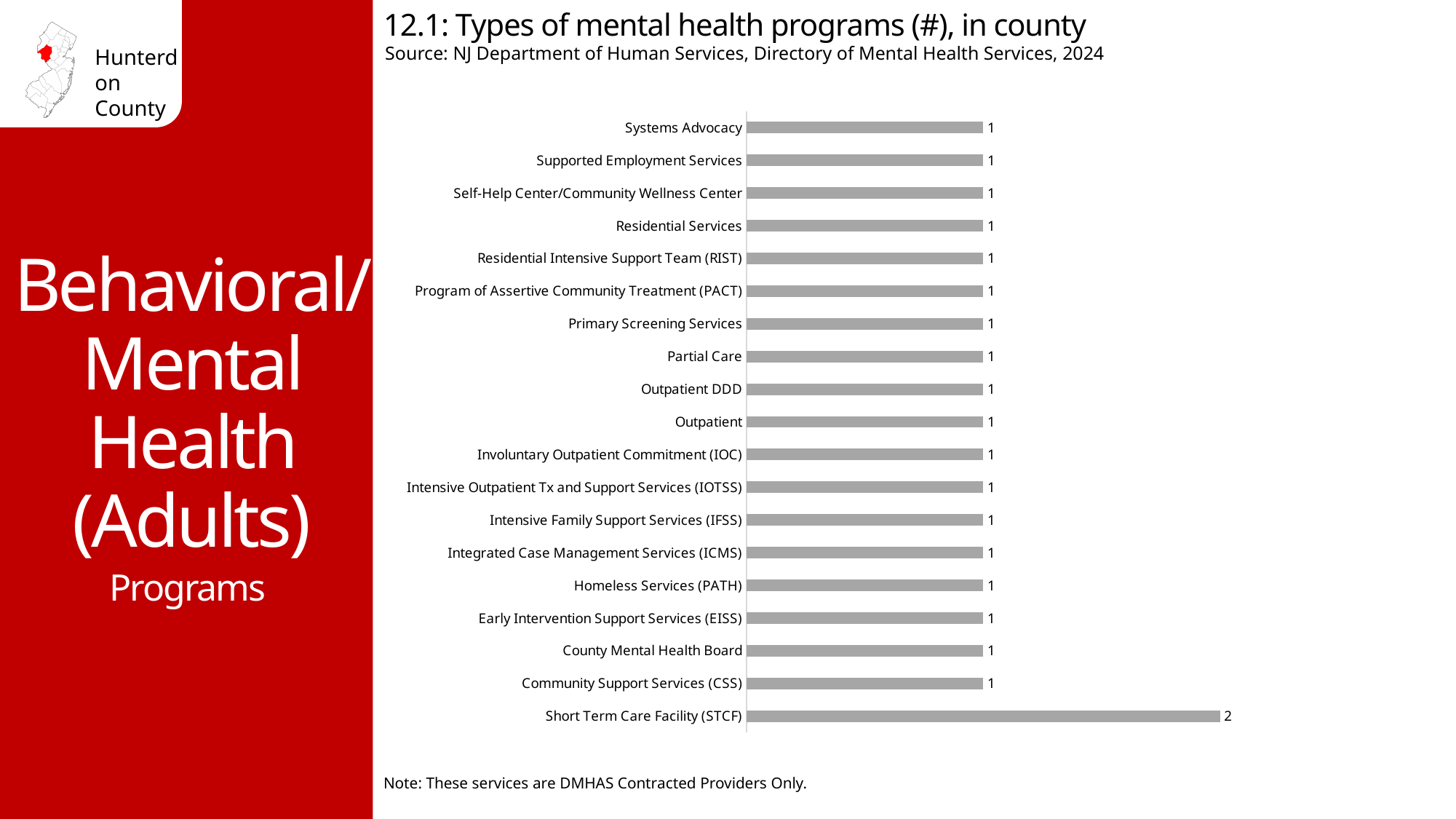
Which program type has the highest number of programs? Short Term Care Facility (STCF) What is the value for Homeless Services (PATH)? 1 Which has more programs, Short Term Care Facility (STCF) or Community Support Services (CSS)? Short Term Care Facility (STCF) How many Short Term Care Facility (STCF) programs are there? 2 How many Partial Care programs are there? 1 What is the difference between the number of Short Term Care Facility (STCF) programs and the number of Outpatient programs? 1 What is the value for Program of Assertive Community Treatment (PACT)? 1 What source is cited for the chart? NJ Department of Human Services, Directory of Mental Health Services, 2024 What is the title of the chart? 12.1: Types of mental health programs (#), in county How many program types are listed in the chart? 19 What type of chart is shown on the slide? bar chart What is the value for Systems Advocacy? 1